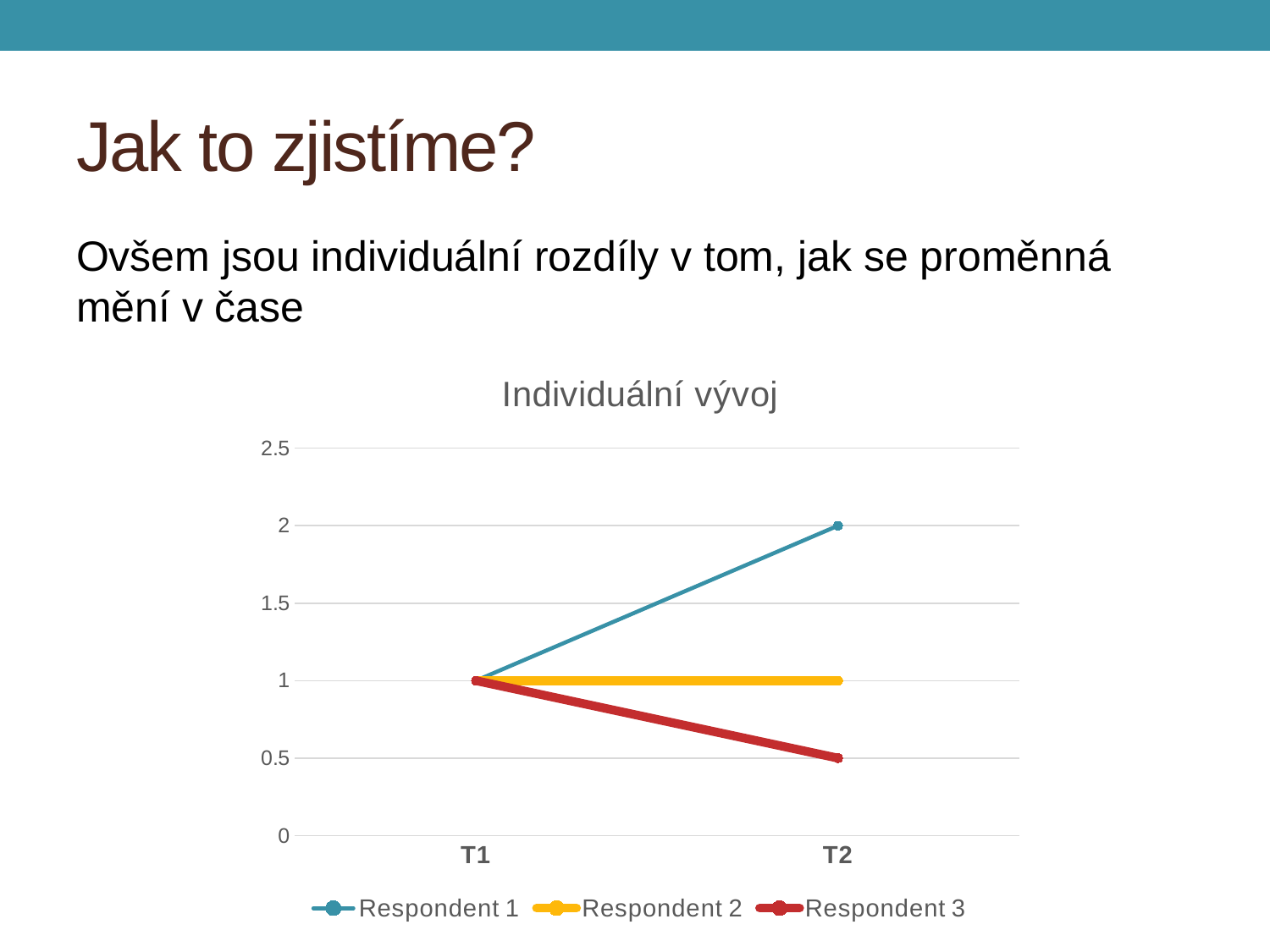
What is the title of the chart? Individuální vývoj Which respondent has the lowest value at T2? Respondent 3 What is the value for Respondent 1 at T2? 2 What is the value for Respondent 2 at T1? 1 What is the value for Respondent 3 at T2? 0.5 How many series does the legend list? 3 Which respondent has the highest value at T2? Respondent 1 Does the value for Respondent 3 rise or fall from T1 to T2? fall Is the value for Respondent 1 at T2 greater or less than 1.5? greater How many points are on the x axis of the chart? 2 What is the difference between Respondent 1 and Respondent 3 at T2? 1.5 What kind of chart is shown on the slide? line chart